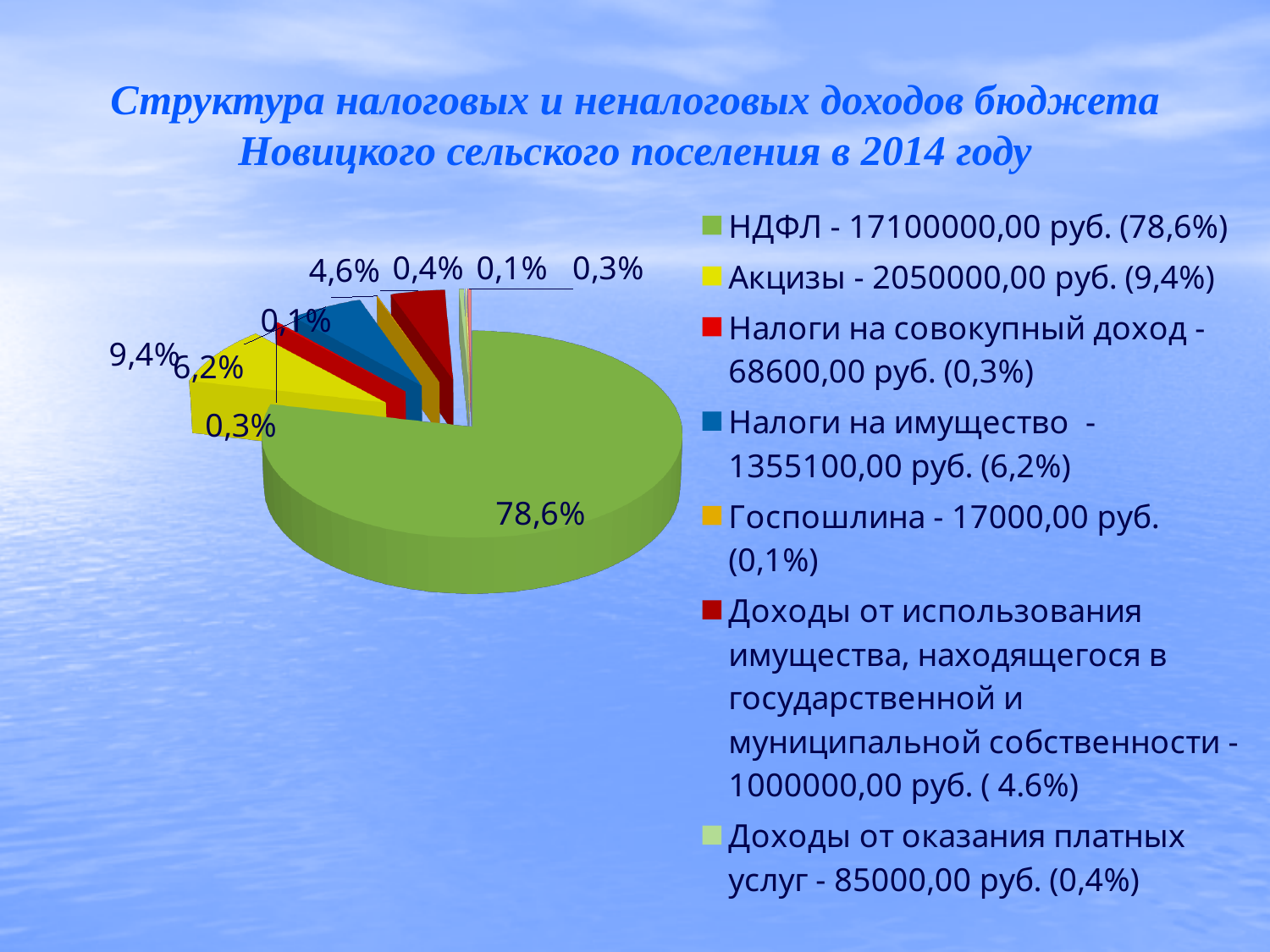
Which category has the largest slice of the pie? НДФЛ What share of the pie does Доходы от оказания платных услуг account for? 0,4% What share of the pie does Налоги на имущество account for? 6,2% Which is larger, the slice for Акцизы or the slice for Налоги на имущество? Акцизы What share of the pie does Акцизы account for? 9,4% What amount in rubles is shown in the legend for Акцизы? 2050000,00 руб. What kind of chart is shown on the slide? pie chart What is the difference in percentage points between the НДФЛ slice and the Акцизы slice? 69,2 What amount in rubles is shown in the legend for Налоги на имущество? 1355100,00 руб. What colour is the НДФЛ slice of the pie? green